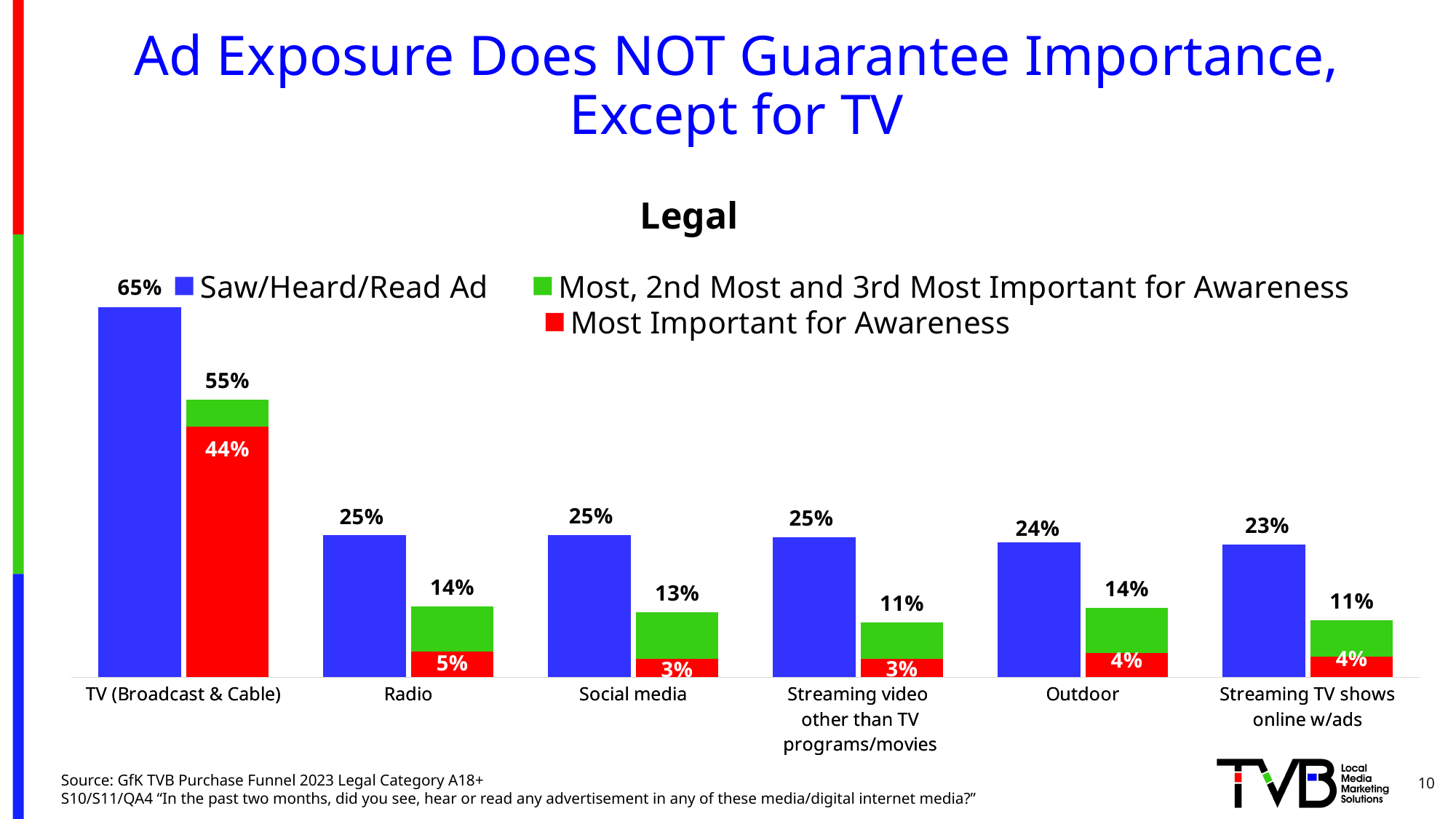
What is the Most Important for Awareness value for TV (Broadcast & Cable)? 44% What is the difference between the Saw/Heard/Read Ad value and the Most, 2nd Most and 3rd Most Important for Awareness value for TV (Broadcast & Cable)? 10% What is the chart's title? Legal Which category has the lowest Saw/Heard/Read Ad value? Streaming TV shows online w/ads What is the Saw/Heard/Read Ad value for TV (Broadcast & Cable)? 65% What is the Most Important for Awareness value for Social media? 3% How many media categories are shown on the x axis? 6 What kind of chart is shown on the slide? bar chart Which is larger: the Most Important for Awareness value for Radio or for Outdoor? Radio Which category has the highest Saw/Heard/Read Ad value? TV (Broadcast & Cable) What is the Most, 2nd Most and 3rd Most Important for Awareness value for Radio? 14% How many series does the legend list? 3